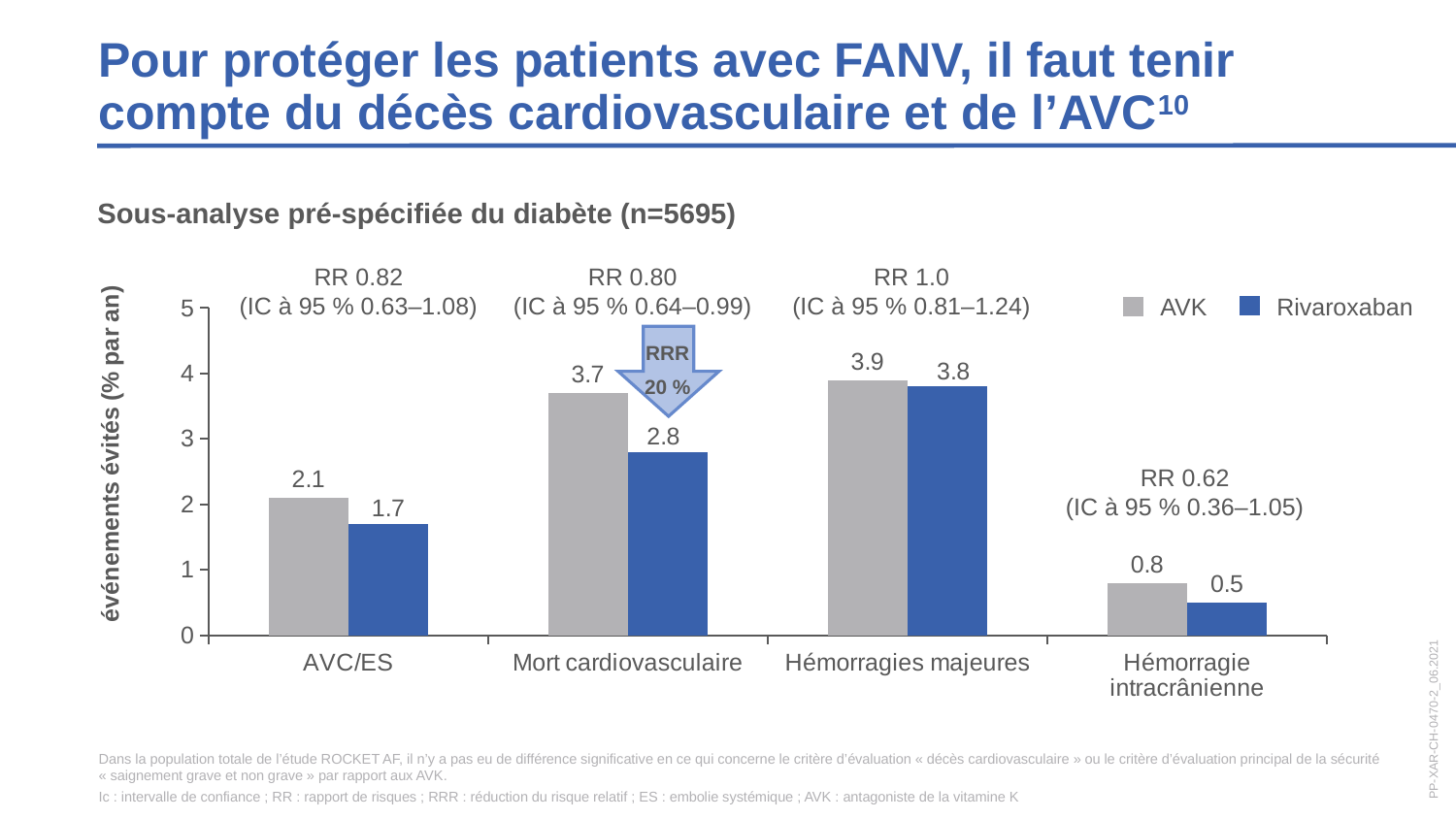
What is the value for AVK in the Hémorragie intracrânienne category? 0.8 Which category has the lowest value for Rivaroxaban? Hémorragie intracrânienne How many series does the legend list? 2 What is the value for AVK in the AVC/ES category? 2.1 How many categories are shown on the x axis? 4 Is the value for AVK in the Hémorragies majeures category greater or less than 3? greater What is the label of the y axis? événements évités (% par an) What kind of chart is shown on the slide? bar chart What is the difference between the AVK and Rivaroxaban values in the Mort cardiovasculaire category? 0.9 What is the value for Rivaroxaban in the Mort cardiovasculaire category? 2.8 Which category has the highest value for AVK? Hémorragies majeures Which is larger in the AVC/ES category, the AVK value or the Rivaroxaban value? AVK